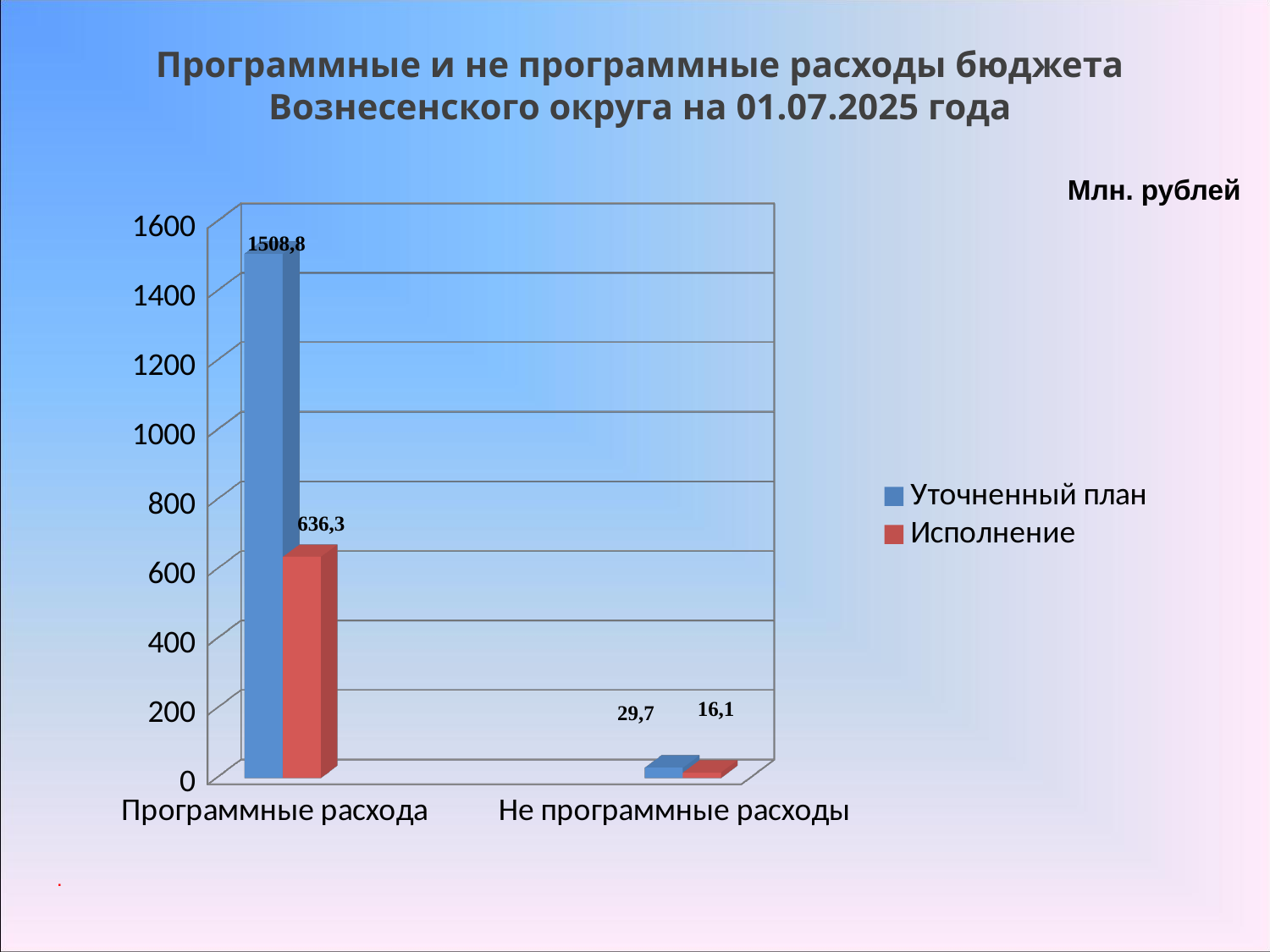
What kind of chart is shown on the slide? Bar chart What is the value of Уточненный план for Не программные расходы? 29,7 What is the value of Исполнение for Не программные расходы? 16,1 What is the difference between Уточненный план and Исполнение for Программные расхода? 872,5 How many categories are shown on the x axis? 2 Which is larger for Программные расхода: Уточненный план or Исполнение? Уточненный план What is the value of Уточненный план for Программные расхода? 1508,8 How many series does the legend list? 2 Which category has the highest Уточненный план value? Программные расхода What is the difference between Уточненный план and Исполнение for Не программные расходы? 13,6 Which category has the lowest Исполнение value? Не программные расходы What is the value of Исполнение for Программные расхода? 636,3